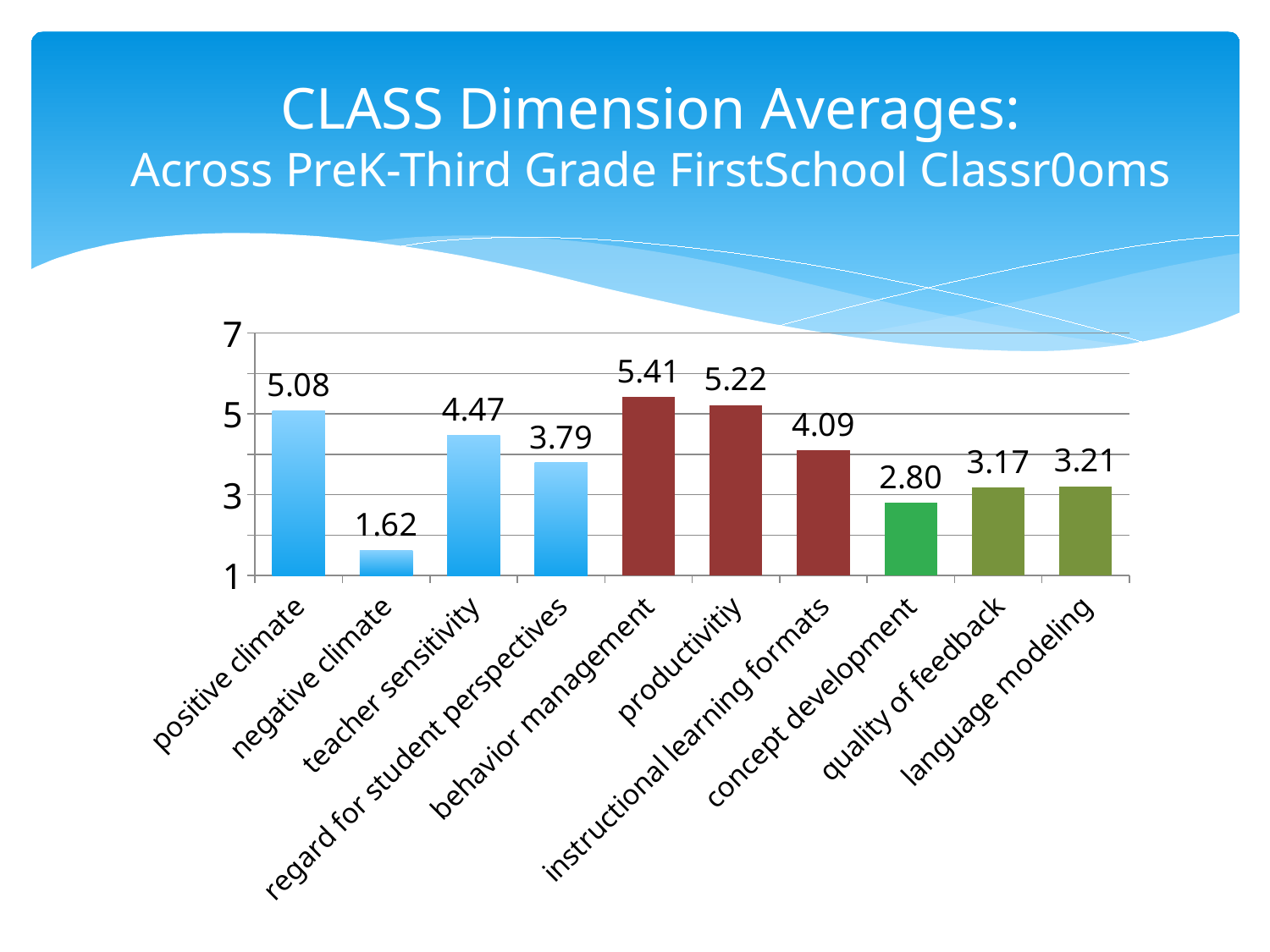
Is the value for quality of feedback greater or less than 3? greater What is the difference between the values for behavior management and productivitiy? 0.19 What is the value for instructional learning formats? 4.09 What is the value for positive climate? 5.08 Which category has the lowest value? negative climate What kind of chart is shown on the slide? bar chart Which is larger, the value for teacher sensitivity or the value for regard for student perspectives? teacher sensitivity What is the difference between the values for positive climate and negative climate? 3.46 What is the title of the chart on the slide? CLASS Dimension Averages: Across PreK-Third Grade FirstSchool Classr0oms What is the value for concept development? 2.80 Which category has the highest value? behavior management How many categories are shown on the x axis? 10